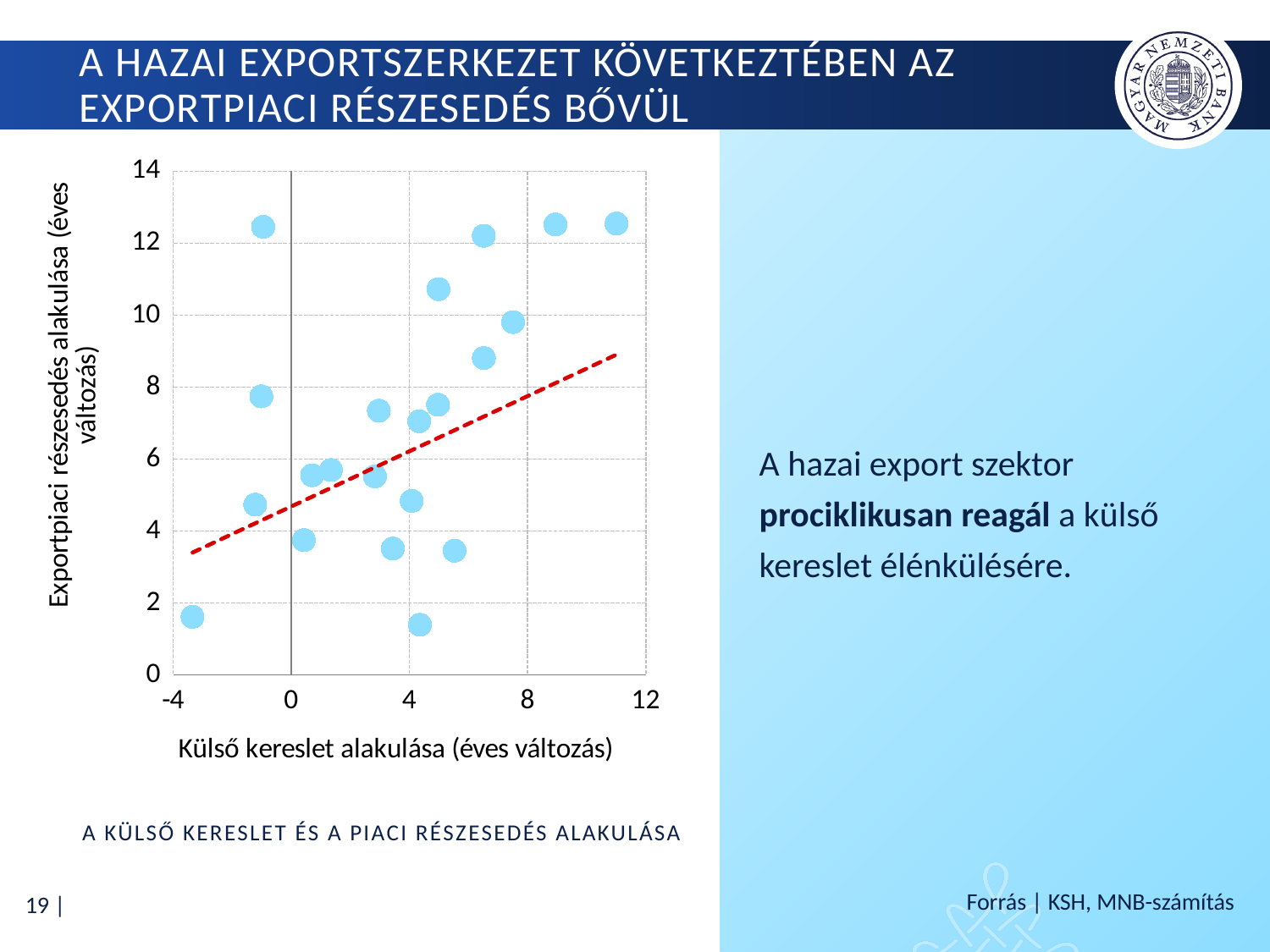
What is the minimum value shown on the horizontal axis? -4 Is the lowest point on the chart (at about 4 on the horizontal axis) above or below 2 on the vertical axis? below Is the value on the vertical axis for the leftmost point (at about -3 on the horizontal axis) greater or less than 2? less Is the vertical-axis value of the rightmost point (at about 11 on the horizontal axis) greater or less than 12? greater What is the title of the chart? A külső kereslet és a piaci részesedés alakulása What kind of chart is shown on the slide? scatter chart What is the maximum value shown on the vertical axis? 14 What is the label of the horizontal axis? Külső kereslet alakulása (éves változás) According to the dashed trend line, does export market share tend to rise or fall as external demand increases? rise